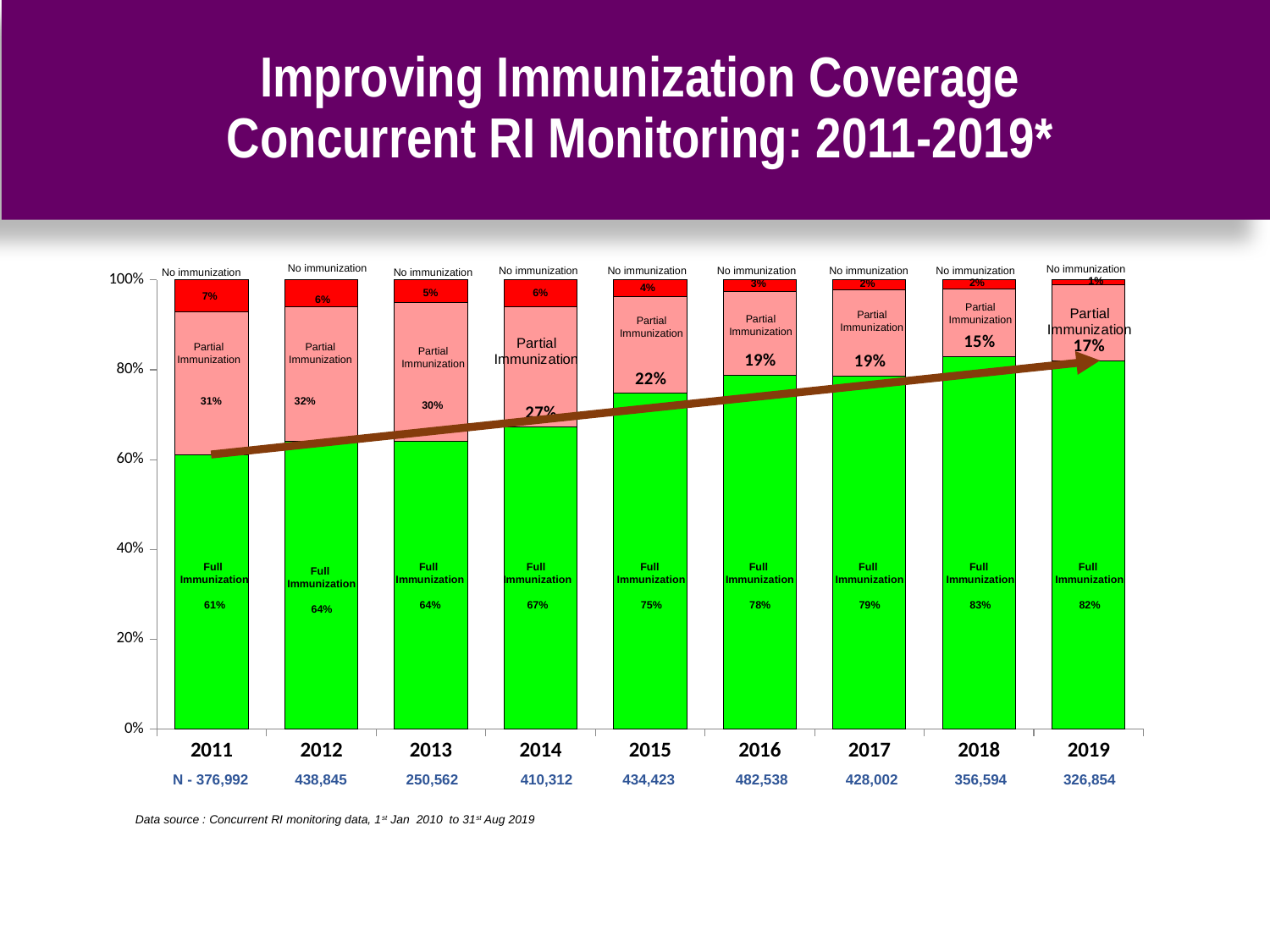
Which year has the lowest Full Immunization percentage? 2011 Which is larger, the Partial Immunization percentage in 2012 or in 2018? 2012 How many years are shown on the x axis of the chart? 9 What is the Full Immunization percentage for 2011? 61% What colour represents Full Immunization in the chart? Green What kind of chart is shown on the slide? Stacked bar chart Which year has the highest Full Immunization percentage? 2018 What is the Partial Immunization percentage for 2015? 22% What is the difference in Full Immunization percentage between 2019 and 2011? 21% Does the Full Immunization percentage generally rise or fall from 2011 to 2019? Rise What is the No immunization percentage for 2019? 1% What is the N value shown for 2016? 482,538